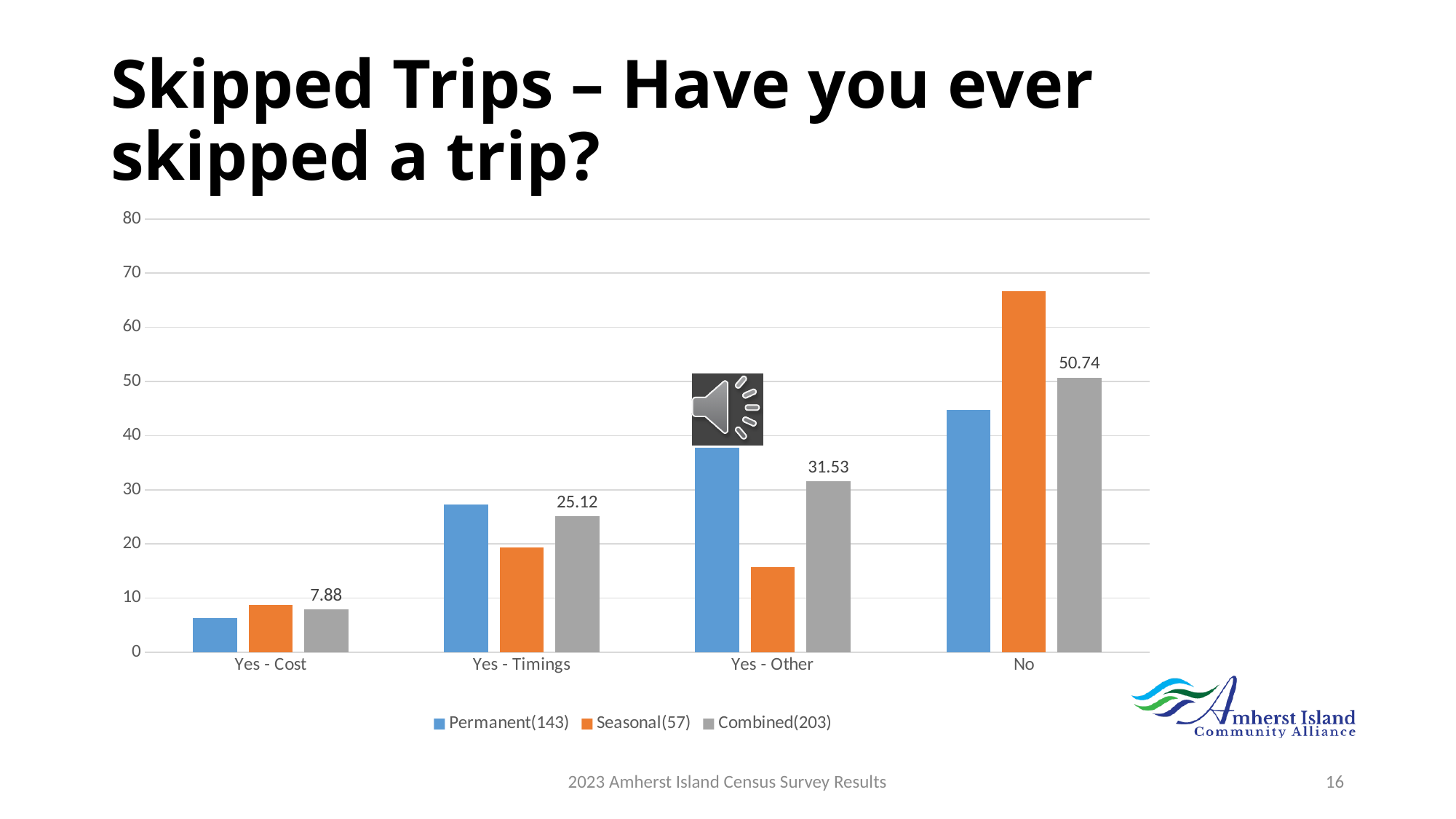
How many series does the legend list? 3 Is the Seasonal(57) value for No greater or less than 60? greater What is the Combined(203) value for No? 50.74 What is the Combined(203) value for Yes - Cost? 7.88 Is the Permanent(143) value for Yes - Timings greater or less than 30? less Which category has the lowest Combined(203) value? Yes - Cost How many categories are shown on the x axis? 4 What is the Combined(203) value for Yes - Other? 31.53 What is the difference between the Combined(203) values for No and Yes - Other? 19.21 What kind of chart is shown on the slide? Bar chart For Yes - Other, which is larger: the Permanent(143) value or the Seasonal(57) value? Permanent(143) Which category has the highest Combined(203) value? No